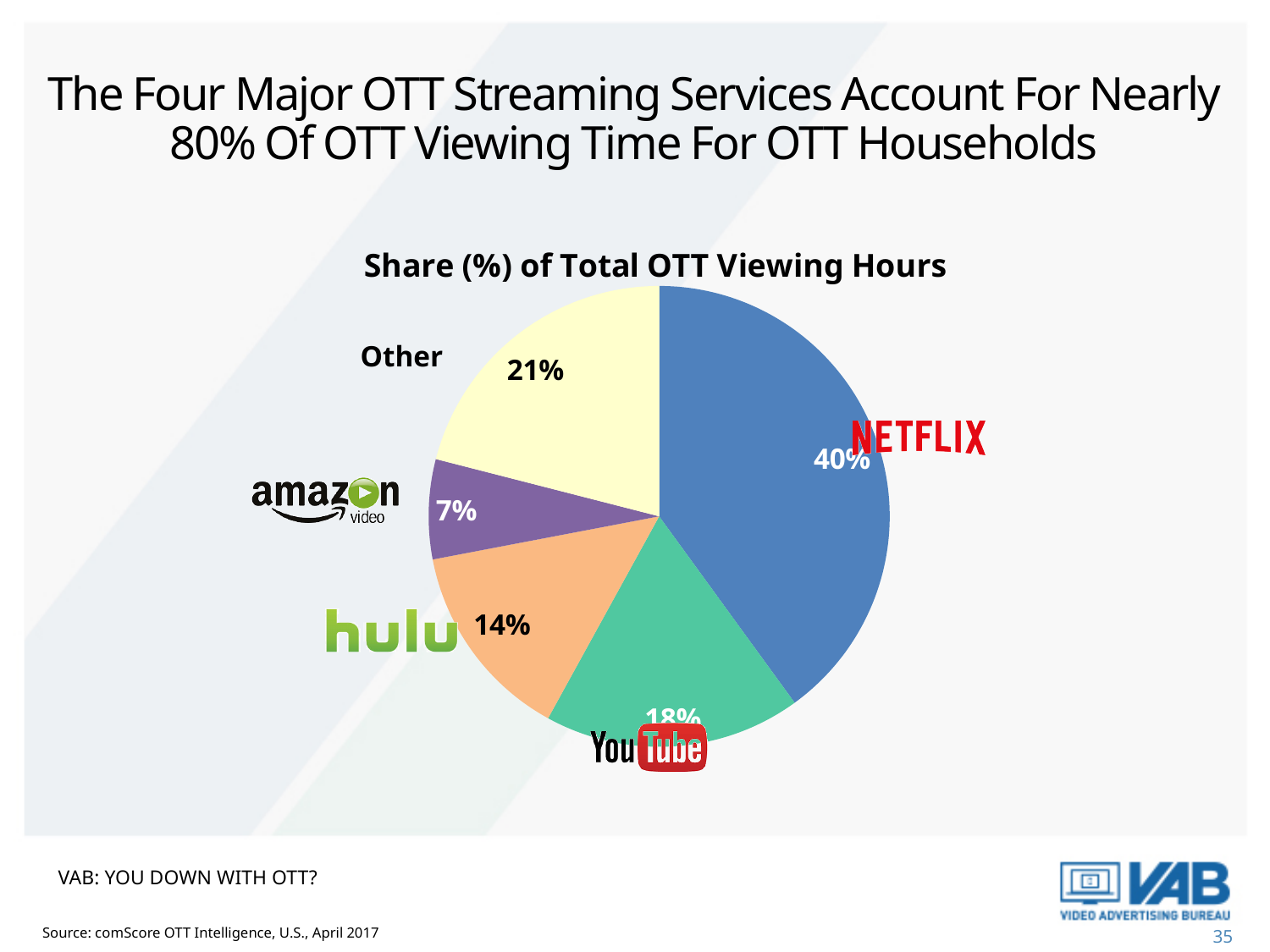
What share of total OTT viewing hours does Hulu account for? 14% Which service has the smallest share of total OTT viewing hours? Amazon Video What share of total OTT viewing hours does Netflix account for? 40% What share of total OTT viewing hours is labelled Other? 21% What share of total OTT viewing hours does Amazon Video account for? 7% What share of total OTT viewing hours does YouTube account for? 18% What type of chart is shown on the slide? pie chart What is the title of the chart? Share (%) of Total OTT Viewing Hours Which has a larger share of OTT viewing hours, Hulu or Other? Other Which service has the largest share of total OTT viewing hours? Netflix How many slices does the pie chart have? 5 What is the difference in share between Netflix and Hulu? 26%